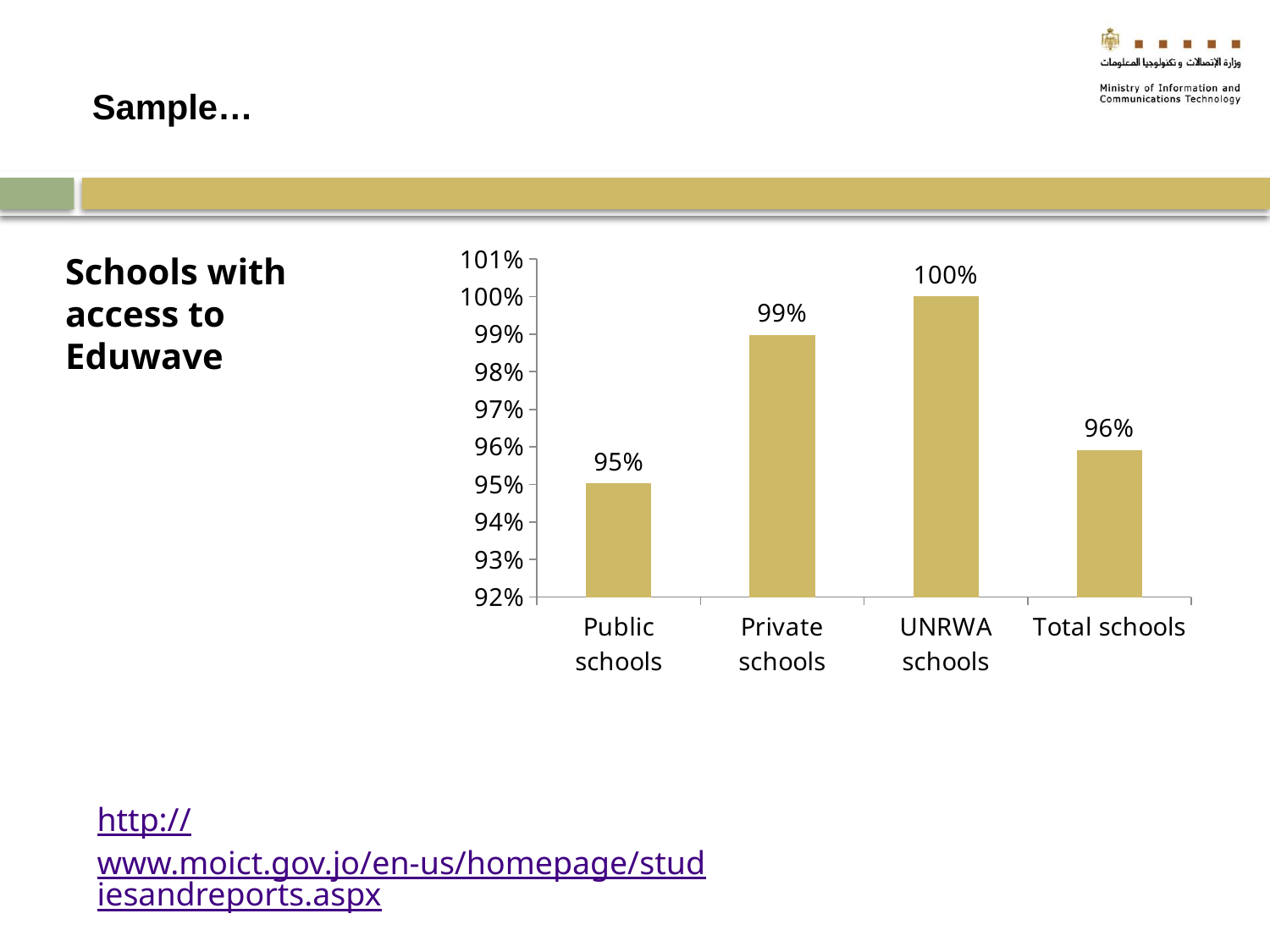
How many categories are shown on the x axis? 4 What is the difference between the values for Private schools and Public schools? 4% What is the value for UNRWA schools? 100% Which is larger, the value for Total schools or the value for Private schools? Private schools Is the value for Public schools greater or less than 97%? less What kind of chart is shown on the slide? Bar chart What is the title text next to the chart? Schools with access to Eduwave What is the value for Public schools? 95% What is the value for Total schools? 96% Which category has the lowest value? Public schools Which category has the highest value? UNRWA schools What is the value for Private schools? 99%